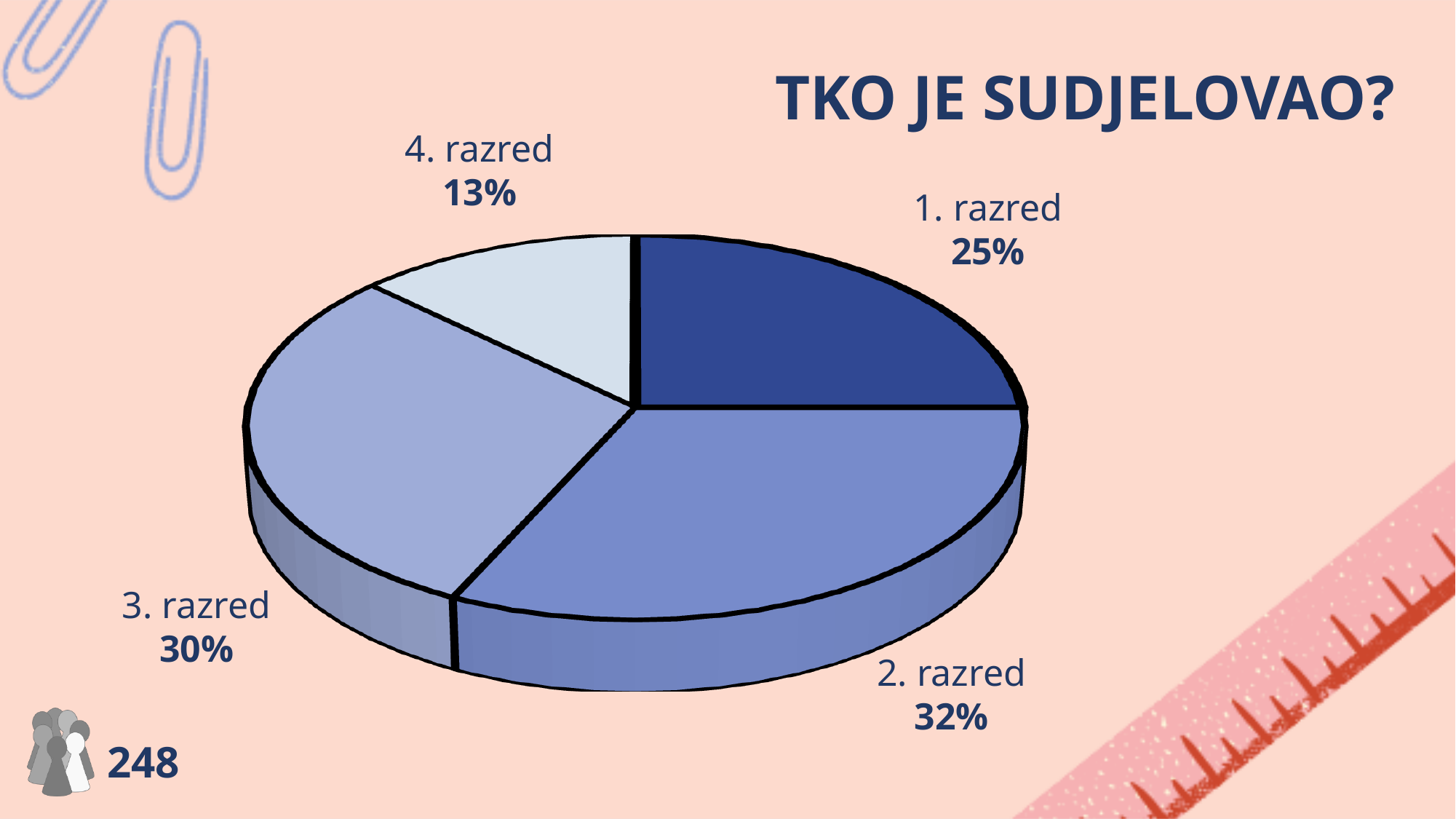
What is the value shown for 1. razred? 25% What is the difference in percentage points between 2. razred and 4. razred? 19 Which category has the smallest slice of the pie? 4. razred How many categories are shown in the pie chart? 4 What is the value shown for 3. razred? 30% What is the difference in percentage points between 3. razred and 1. razred? 5 What is the title shown on the slide above the chart? TKO JE SUDJELOVAO? What kind of chart is shown on the slide? Pie chart What share of the pie does 4. razred have? 13% What share of the pie does 2. razred have? 32% Which is larger, the slice for 1. razred or the slice for 4. razred? 1. razred Which category has the largest slice of the pie? 2. razred